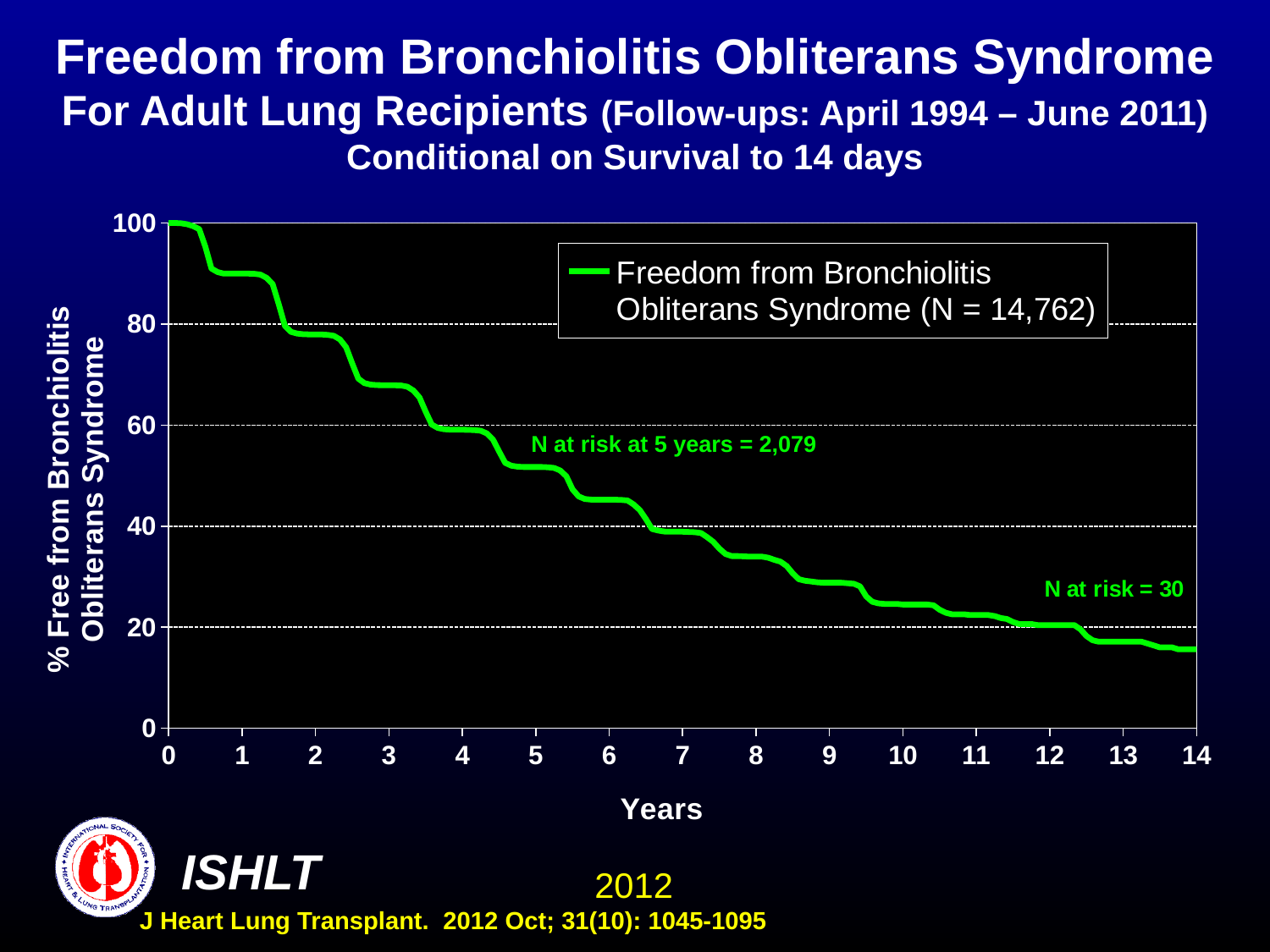
What is the N at risk shown near the right end of the curve? 30 Is the value for freedom from bronchiolitis obliterans syndrome at 3 years greater or less than 60? greater What is the total N given in the legend for the Freedom from Bronchiolitis Obliterans Syndrome series? 14,762 What colour is the line plotted on the chart? green Is the value for freedom from bronchiolitis obliterans syndrome at 1 year greater or less than 80? greater Is the value for freedom from bronchiolitis obliterans syndrome at 14 years greater or less than 20? less What is the N at risk at 5 years shown on the chart? 2,079 How many series does the legend list? 1 What kind of chart is shown on the slide? line chart Does the percentage free from bronchiolitis obliterans syndrome rise or fall as years increase? fall